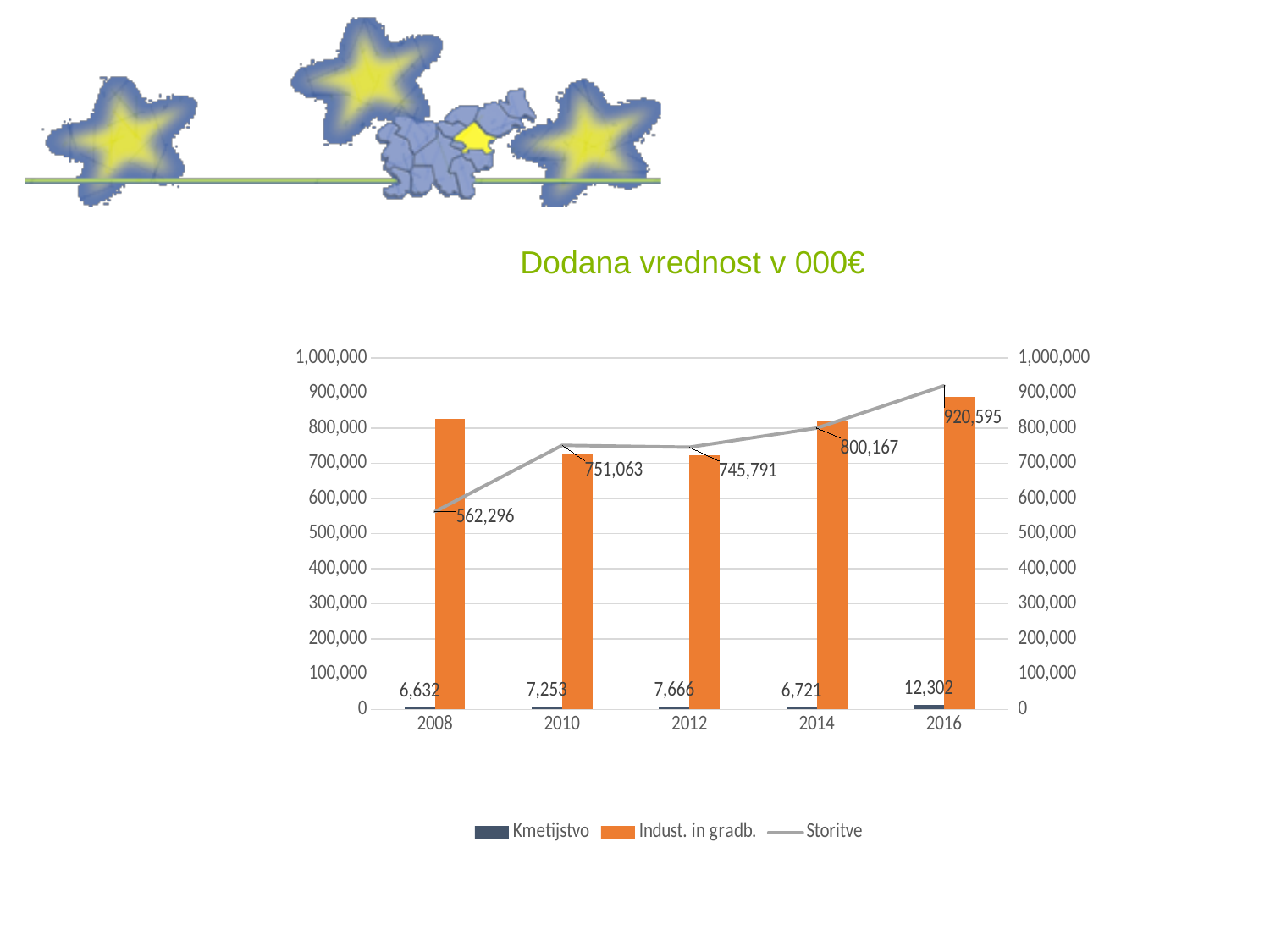
How many series does the legend list? 3 What is the difference between the Storitve values in 2016 and 2014? 120,428 What is the value for Storitve in 2014? 800,167 How many years are shown on the x axis? 5 Is the value for Indust. in gradb. in 2010 greater or less than 800,000? less What is the value for Storitve in 2008? 562,296 Which is larger, the Storitve value in 2010 or in 2012? 2010 Is the value for Indust. in gradb. in 2008 greater or less than 800,000? greater In which year is the Kmetijstvo value highest? 2016 What is the value for Kmetijstvo in 2016? 12,302 In which year is the Storitve value lowest? 2008 What is the title of the chart? Dodana vrednost v 000€